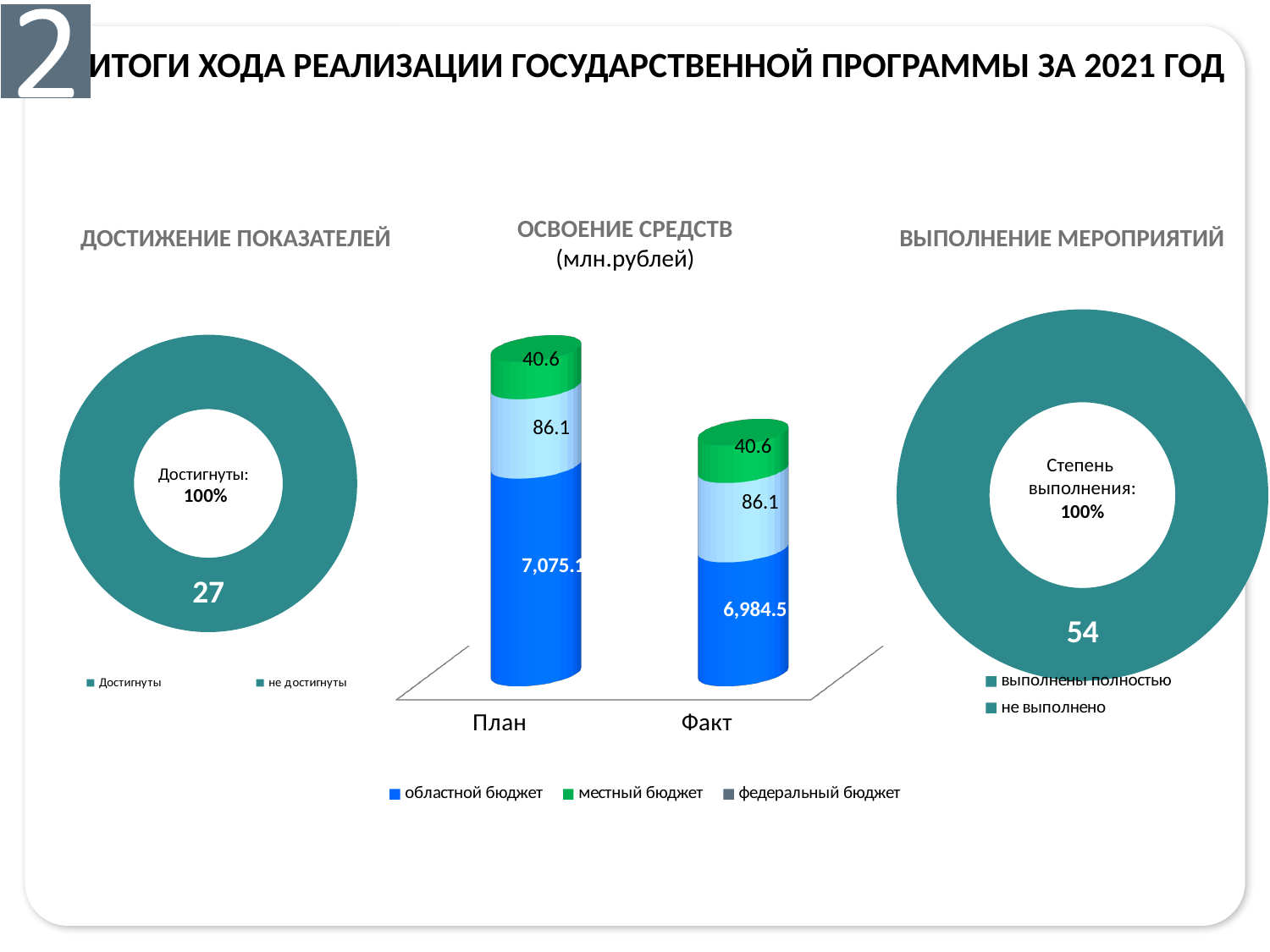
In the ОСВОЕНИЕ СРЕДСТВ chart, what is the value of областной бюджет for План? 7,075.1 In the ОСВОЕНИЕ СРЕДСТВ chart, what is the difference between the областной бюджет values for План and Факт? 90.6 What kind of chart is the ОСВОЕНИЕ СРЕДСТВ chart? Stacked bar chart In the ДОСТИЖЕНИЕ ПОКАЗАТЕЛЕЙ chart on the left, what number is printed on the ring? 27 In the ОСВОЕНИЕ СРЕДСТВ chart, what is the total of the Факт stacked bar? 7,111.2 In the ОСВОЕНИЕ СРЕДСТВ chart, which has the larger областной бюджет value, План or Факт? План In the ОСВОЕНИЕ СРЕДСТВ chart, what is the total of the План stacked bar? 7,201.8 In the ОСВОЕНИЕ СРЕДСТВ chart, what is the value of областной бюджет for Факт? 6,984.5 In the ОСВОЕНИЕ СРЕДСТВ chart, what is the value of the top (green) segment of the План bar? 40.6 How many categories are shown on the x axis of the ОСВОЕНИЕ СРЕДСТВ chart? 2 In the ВЫПОЛНЕНИЕ МЕРОПРИЯТИЙ chart on the right, what number is printed on the ring? 54 How many series does the legend of the ОСВОЕНИЕ СРЕДСТВ chart list? 3